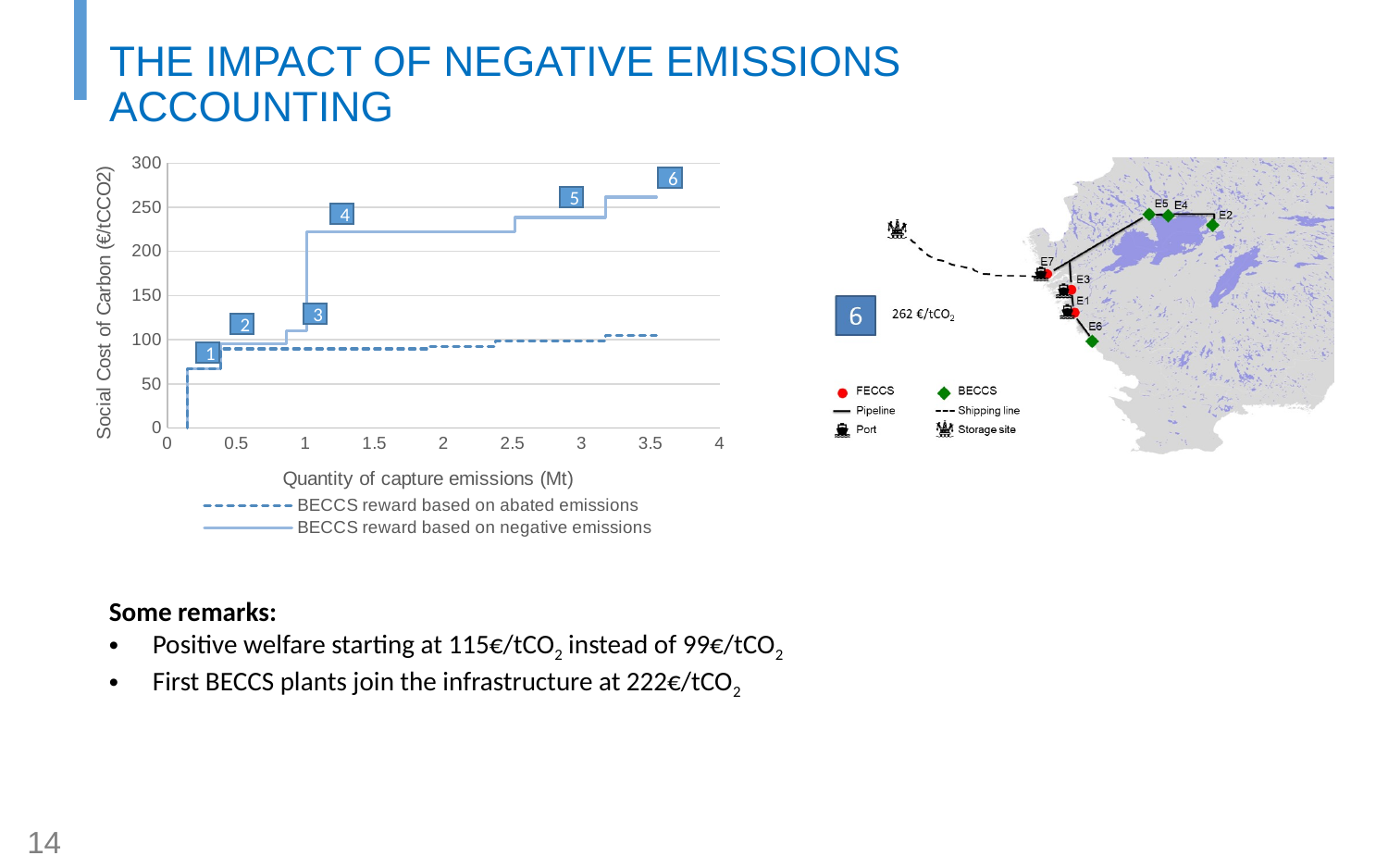
Which step label is placed at the highest point of the 'BECCS reward based on negative emissions' series? 6 At a quantity of 3.5 Mt, is the value of the 'BECCS reward based on negative emissions' series greater or less than 250? greater How many series does the legend of the chart list? 2 What is the highest value shown on the y axis of the chart? 300 At a quantity of 2 Mt, is the value of the 'BECCS reward based on negative emissions' series greater or less than 200? greater How many numbered step labels are shown on the chart? 6 At a quantity of 3 Mt, which series has the higher value: 'BECCS reward based on abated emissions' or 'BECCS reward based on negative emissions'? BECCS reward based on negative emissions Do the values of the 'BECCS reward based on negative emissions' series rise or fall as the quantity of captured emissions increases? rise At a quantity of 2 Mt, is the value of the 'BECCS reward based on abated emissions' series greater or less than 100? less What is the title of the x axis of the chart? Quantity of capture emissions (Mt) What kind of chart is shown on the left of the slide? line chart What is the title of the y axis of the chart? Social Cost of Carbon (€/tCCO2)